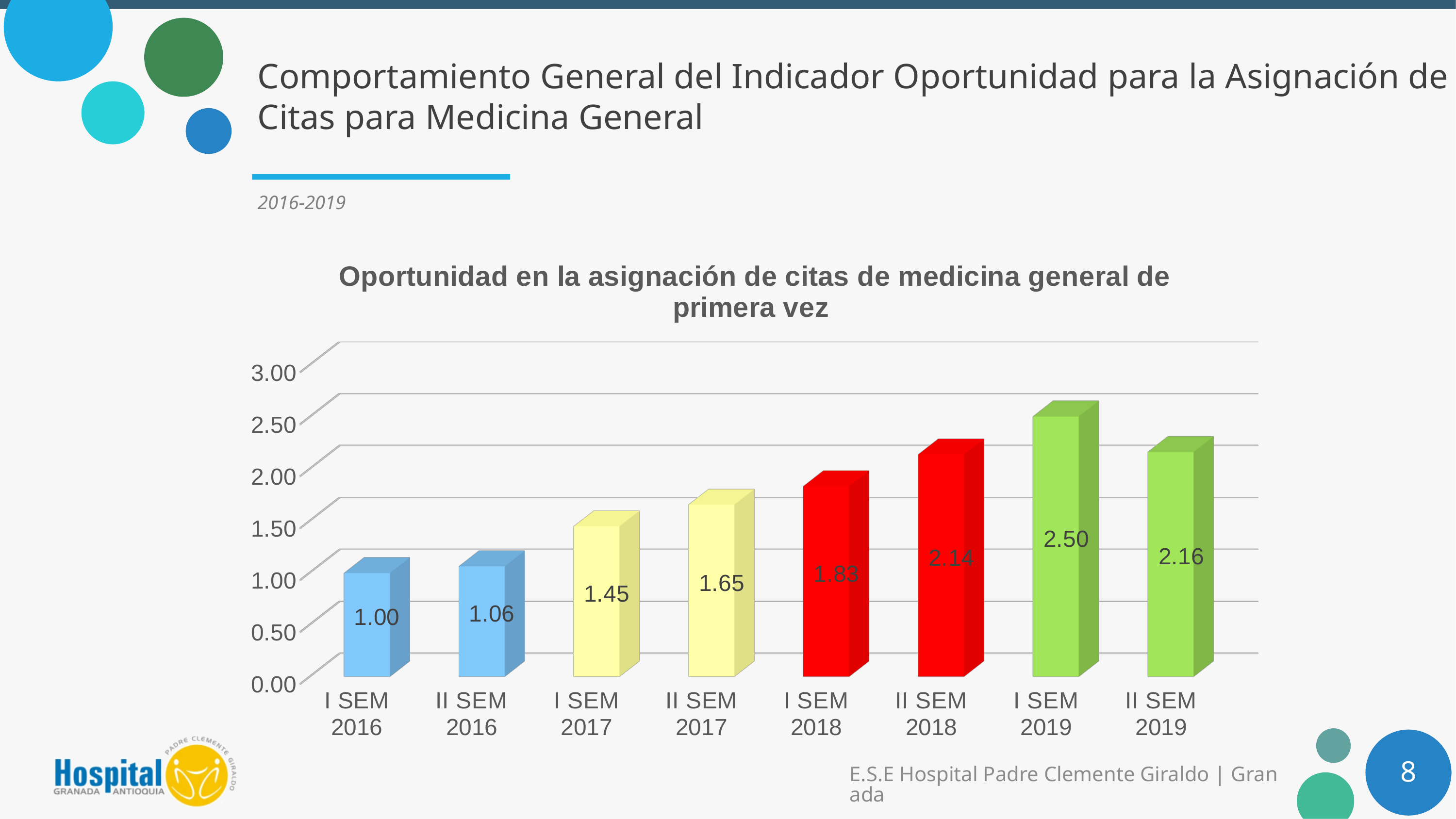
What kind of chart is shown on the slide? Bar chart What is the value for I SEM 2016? 1.00 What is the value for II SEM 2019? 2.16 Which period has the highest value? I SEM 2019 Which is larger, the value for II SEM 2018 or the value for II SEM 2019? II SEM 2019 How many periods (bars) are shown in the chart? 8 What is the value for II SEM 2018? 2.14 What is the difference between the values for I SEM 2018 and I SEM 2017? 0.38 What is the difference between the values for I SEM 2019 and I SEM 2016? 1.50 Which period has the lowest value? I SEM 2016 What is the title of the chart? Oportunidad en la asignación de citas de medicina general de primera vez What is the value for II SEM 2017? 1.65